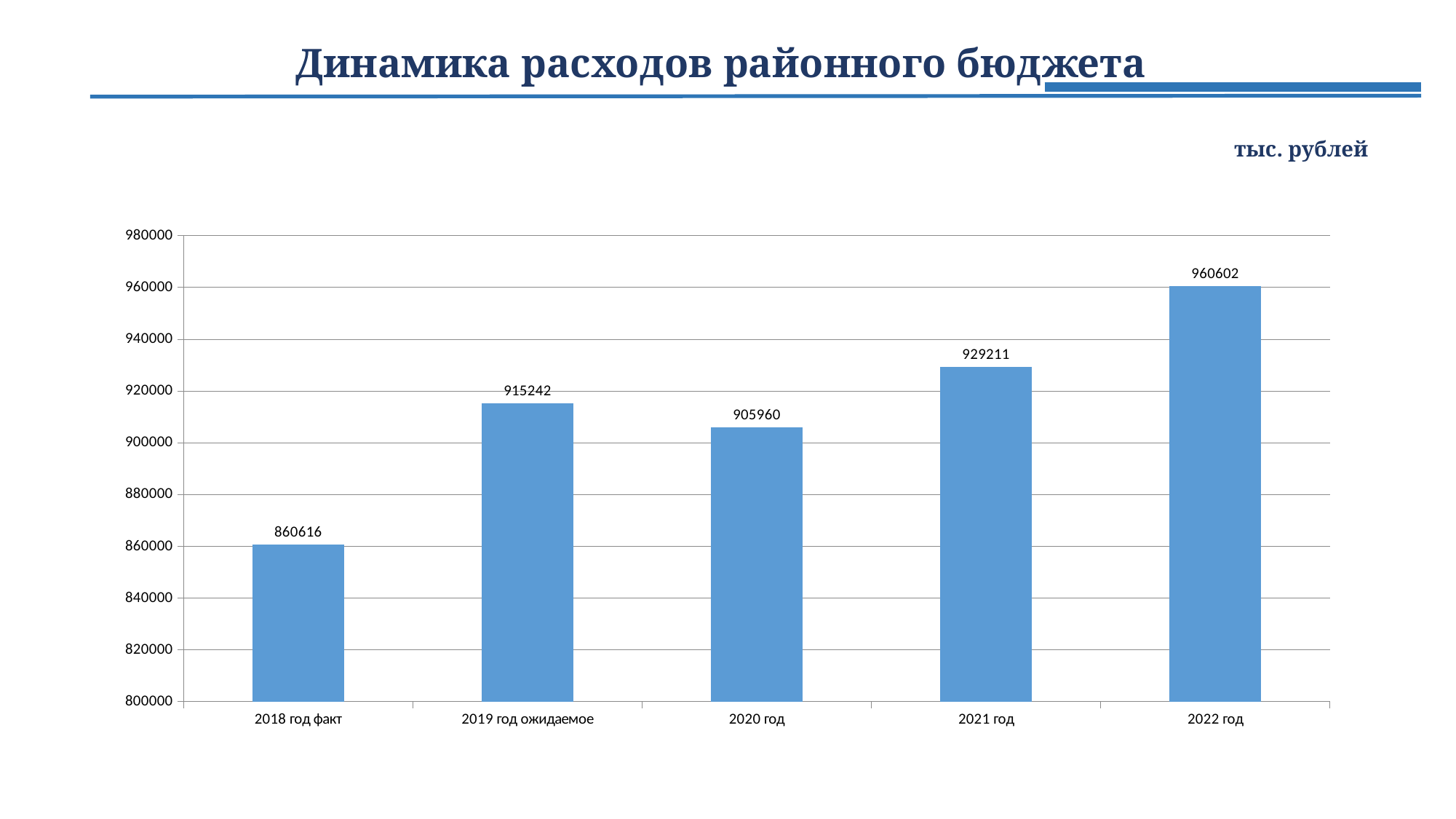
Which category has the lowest value? 2018 год факт What is the value for 2018 год факт? 860616 What is the title of the chart? Динамика расходов районного бюджета Which is larger, the value for 2019 год ожидаемое or the value for 2020 год? 2019 год ожидаемое What kind of chart is shown on the slide? bar chart What is the value for 2020 год? 905960 How many categories are shown on the x axis? 5 What is the difference between the values for 2022 год and 2021 год? 31391 What is the value for 2022 год? 960602 Is the value for 2021 год greater or less than 920000? greater Which category has the highest value? 2022 год What is the value for 2019 год ожидаемое? 915242